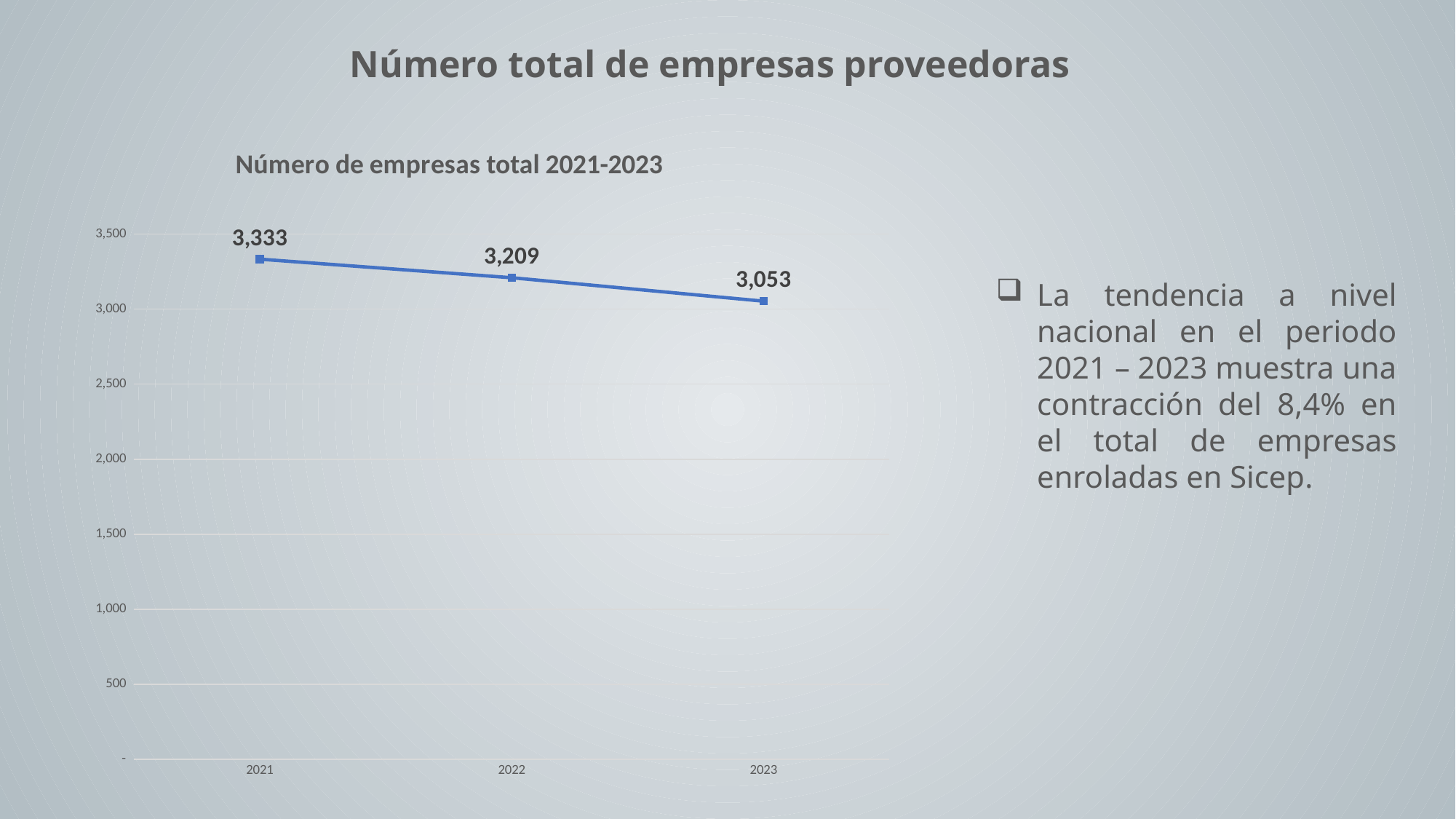
How many years are plotted on the chart? 3 What kind of chart is shown? line chart What is the value for 2022? 3,209 What is the difference between the values for 2021 and 2023? 280 Is the value for 2023 greater or less than 3,000? greater Do the values rise or fall from 2021 to 2023? fall Which year has the lowest value? 2023 Which is larger, the value for 2022 or the value for 2023? 2022 What is the value for 2023? 3,053 What is the difference between the values for 2021 and 2022? 124 What is the value for 2021? 3,333 Which year has the highest value? 2021